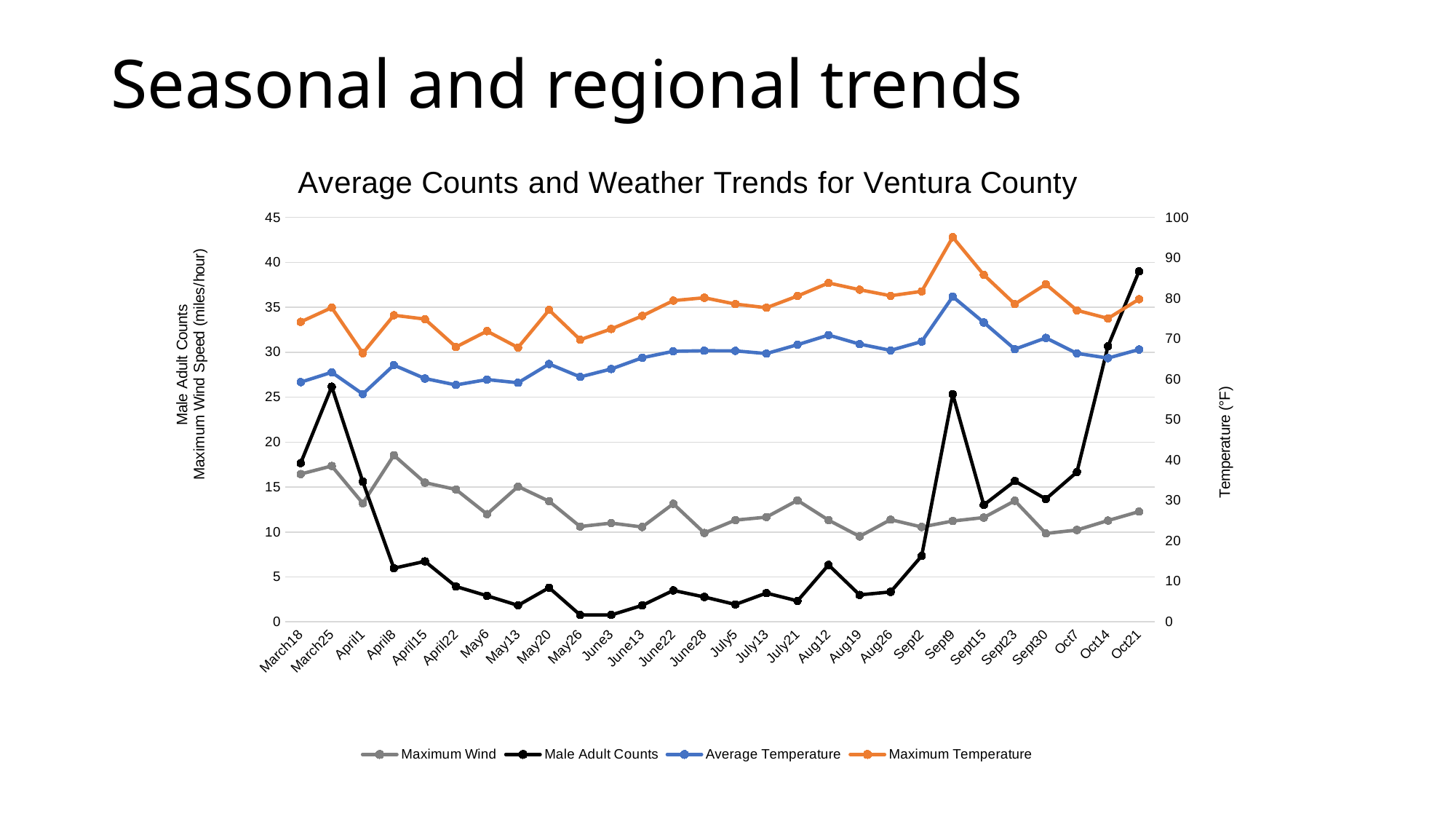
How many series does the legend list? 4 Which is larger, the Male Adult Counts value for Sept9 or for Sept15? Sept9 Do the Male Adult Counts values rise or fall from March25 to May26? fall What is the title of the chart? Average Counts and Weather Trends for Ventura County What kind of chart is shown on the slide? line chart Is the Maximum Temperature value for Sept9 greater or less than 90? greater Is the Male Adult Counts value for Oct21 greater or less than 35? greater On which date is the Maximum Temperature value highest? Sept9 Is the Average Temperature value for April1 greater or less than 60? less How many dates are plotted along the x axis? 28 On which date is the Male Adult Counts value highest? Oct21 What is the label of the right-hand vertical axis? Temperature (°F)